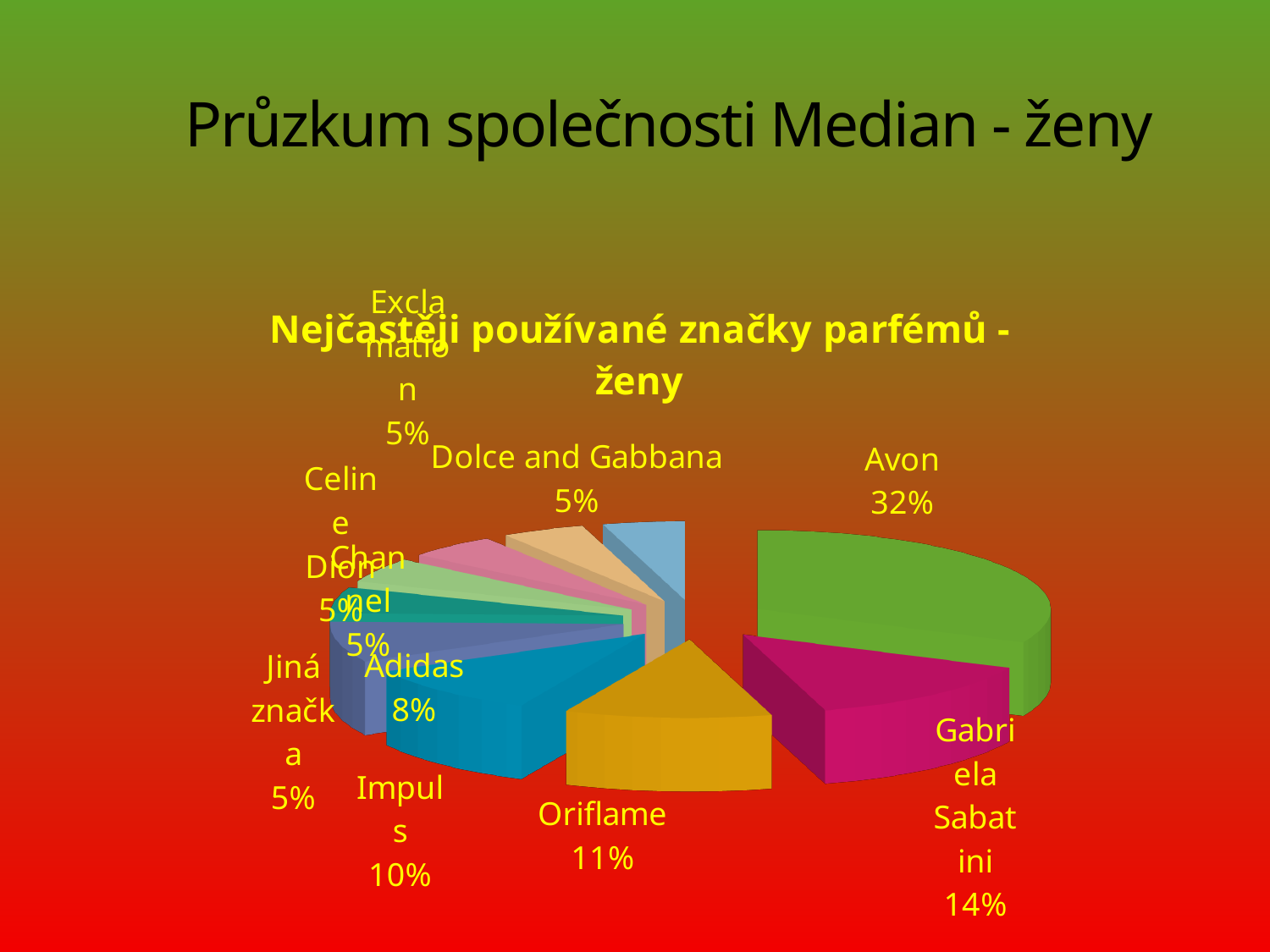
What kind of chart is shown on the slide? pie chart Which brand has the largest slice of the pie? Avon What is the title of the chart? Nejčastěji používané značky parfémů - ženy What share of the pie does Gabriela Sabatini have? 14% Which has a larger share, Oriflame or Impuls? Oriflame What share of the pie does Oriflame have? 11% What share of the pie does Avon have? 32% What share of the pie does Adidas have? 8% What share of the pie does Dolce and Gabbana have? 5% What is the difference in percentage points between Avon and Gabriela Sabatini? 18 Which has a larger share, Adidas or Gabriela Sabatini? Gabriela Sabatini What share of the pie does Impuls have? 10%